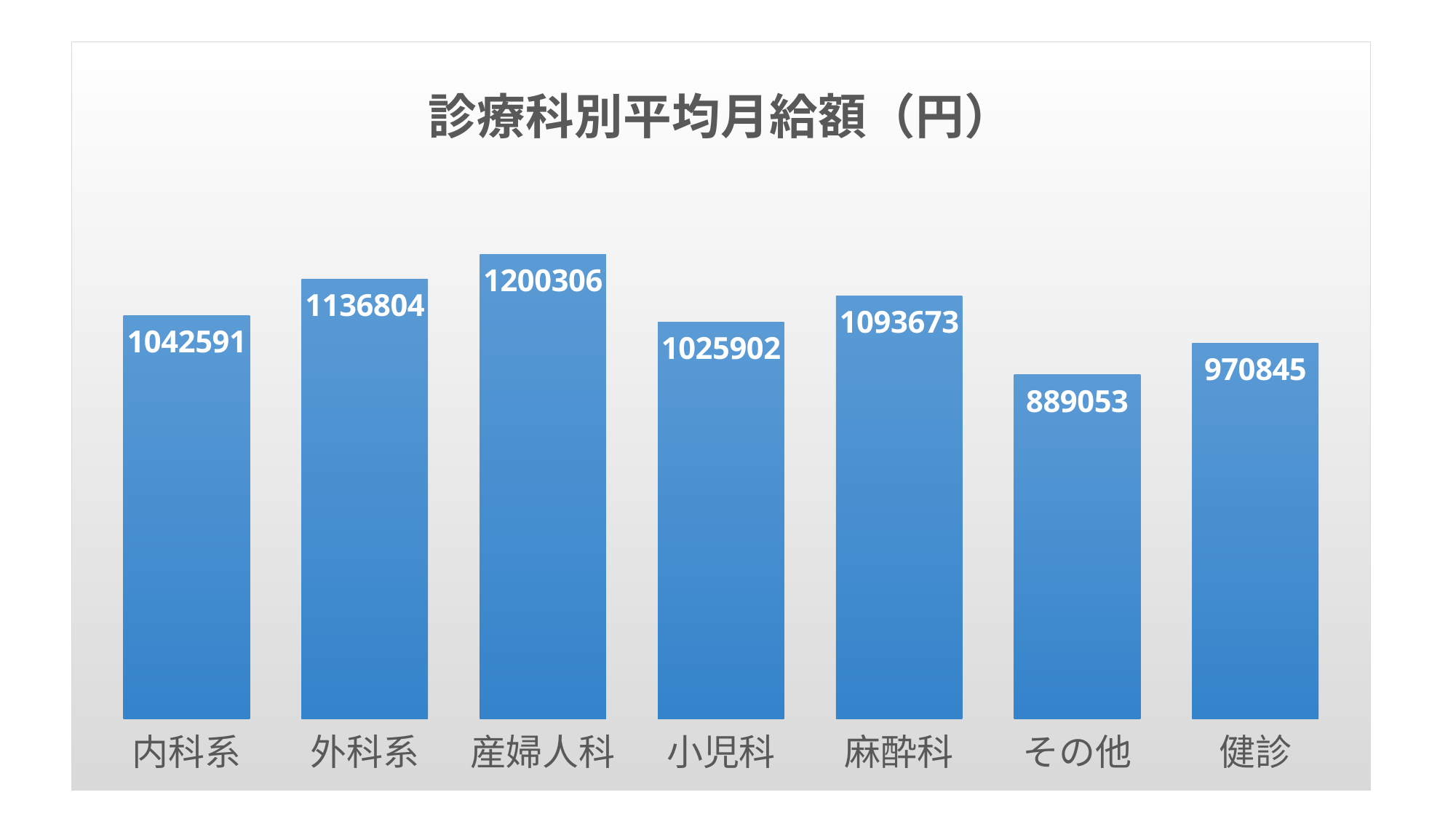
What kind of chart is this? bar chart What is the value for その他? 889053 What is the value for 内科系? 1042591 Which is larger, the value for 内科系 or the value for 小児科? 内科系 What is the value for 健診? 970845 How many categories are shown in the chart? 7 What is the title of the chart? 診療科別平均月給額（円） Which category has the lowest value? その他 What is the difference between the values for 産婦人科 and その他? 311253 Which category has the highest value? 産婦人科 What is the value for 産婦人科? 1200306 What is the difference between the values for 外科系 and 麻酔科? 43131